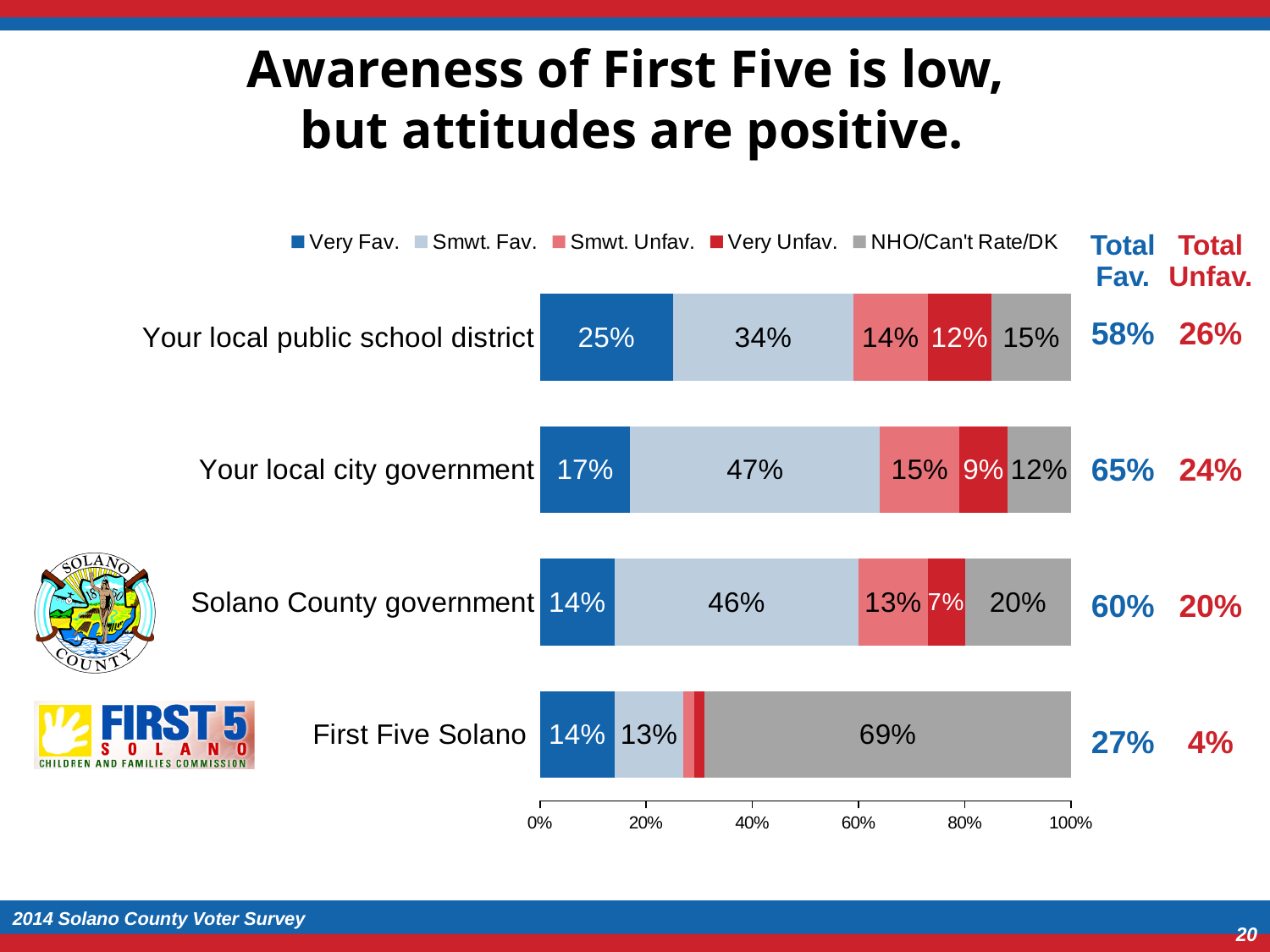
Which has a larger Very Unfav. value: Your local public school district or Solano County government? Your local public school district What Total Fav. figure is shown next to the bar for Your local city government? 65% Which category has the lowest Smwt. Fav. value? First Five Solano What is the Smwt. Fav. value for Your local city government? 47% What is the Very Fav. value for Your local public school district? 25% How many categories (bars) are plotted in the chart? 4 Which category has the highest Very Fav. value? Your local public school district Which category has the highest NHO/Can't Rate/DK value? First Five Solano What kind of chart is shown on the slide? bar chart What is the NHO/Can't Rate/DK value for First Five Solano? 69% How many series does the legend list? 5 What is the difference between the Smwt. Fav. values for Your local city government and Your local public school district? 13 percentage points